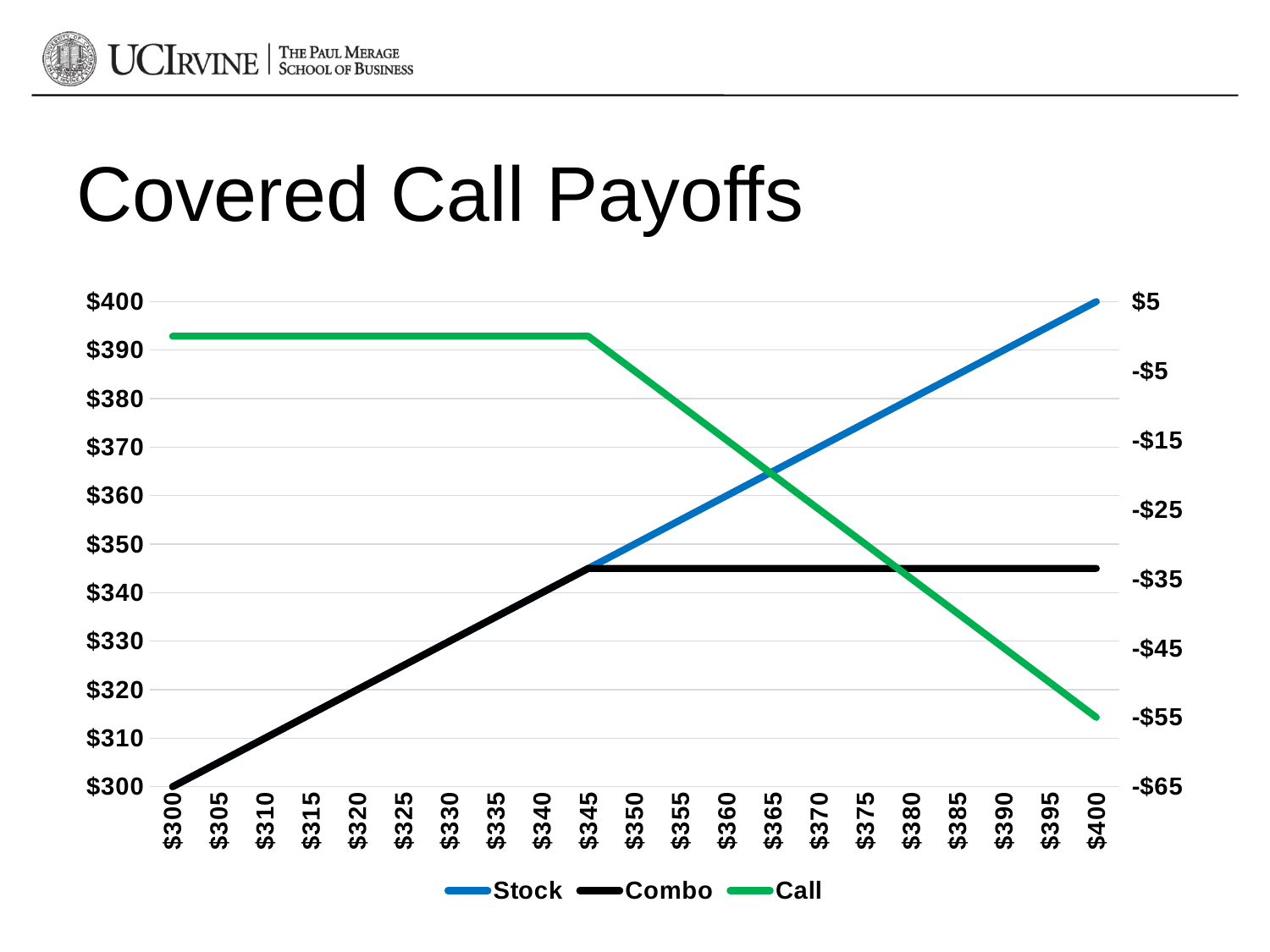
What colour is the Call series line? green Is the value of the Call series at a stock price of $300 greater or less than -$5 on the right axis? greater What is the value of the Combo series at a stock price of $340? $340 How many stock price points are labelled along the x axis? 21 What kind of chart is shown on the slide? line chart What is the difference between the Stock value at $400 and the Stock value at $300? $100 How many series does the legend list? 3 At a stock price of $400, which is larger, the Stock value or the Combo value? Stock Does the Stock series rise or fall as the stock price increases along the x axis? rise Is the value of the Combo series at a stock price of $400 greater or less than $350? less What is the value of the Stock series at a stock price of $400? $400 What is the value of the Combo series at a stock price of $300? $300